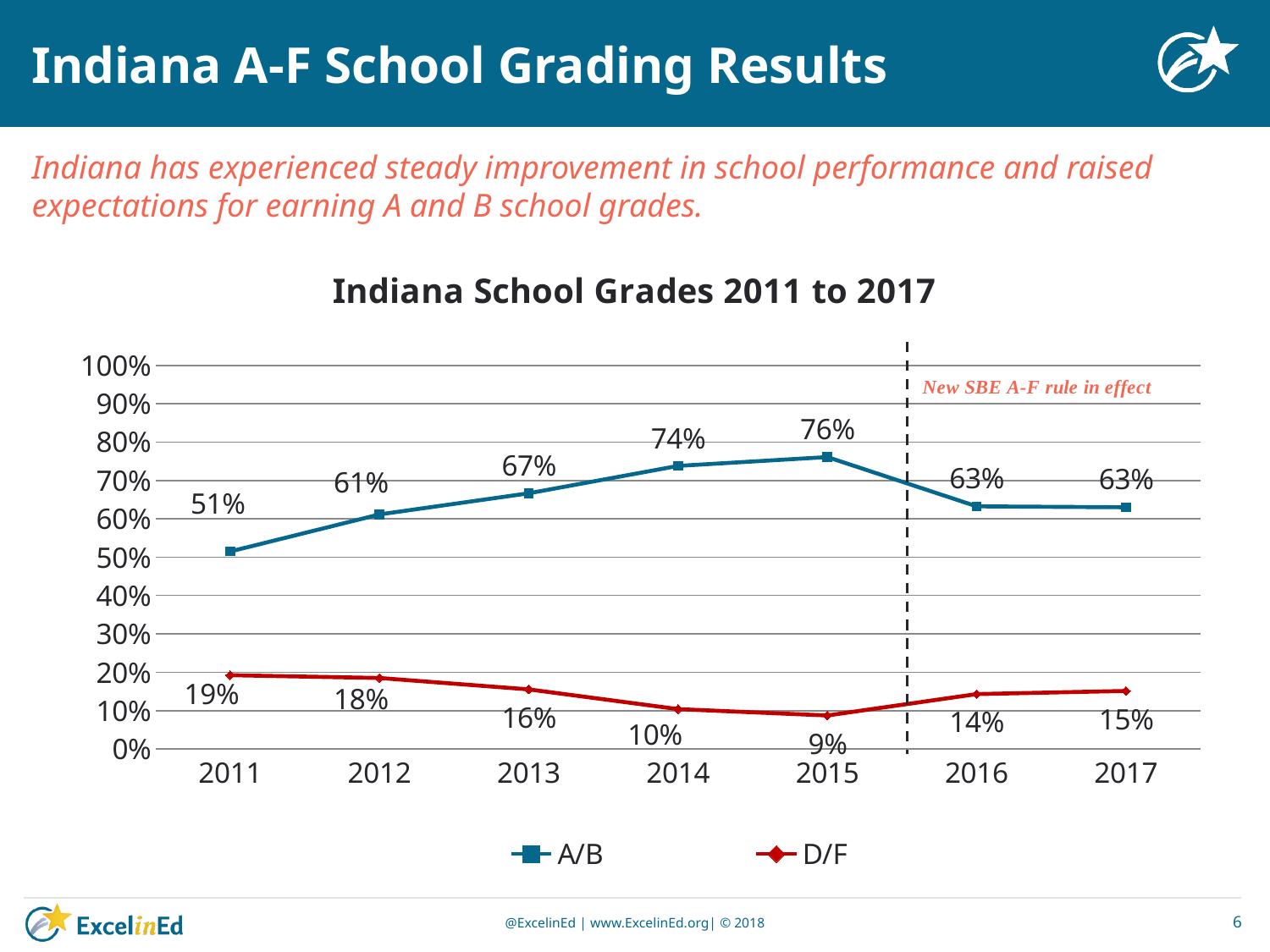
What is the title of the chart? Indiana School Grades 2011 to 2017 Which is larger, the D/F value in 2011 or the D/F value in 2017? 2011 What kind of chart is shown? Line chart What is the difference between the A/B value in 2015 and the A/B value in 2016? 13% In which year is the D/F series lowest? 2015 How many series does the legend list? 2 What is the A/B value for 2015? 76% What is the D/F value for 2014? 10% How many years are shown on the x axis? 7 In which year is the A/B series highest? 2015 Does the A/B series rise or fall from 2011 to 2015? Rise What is the A/B value for 2011? 51%